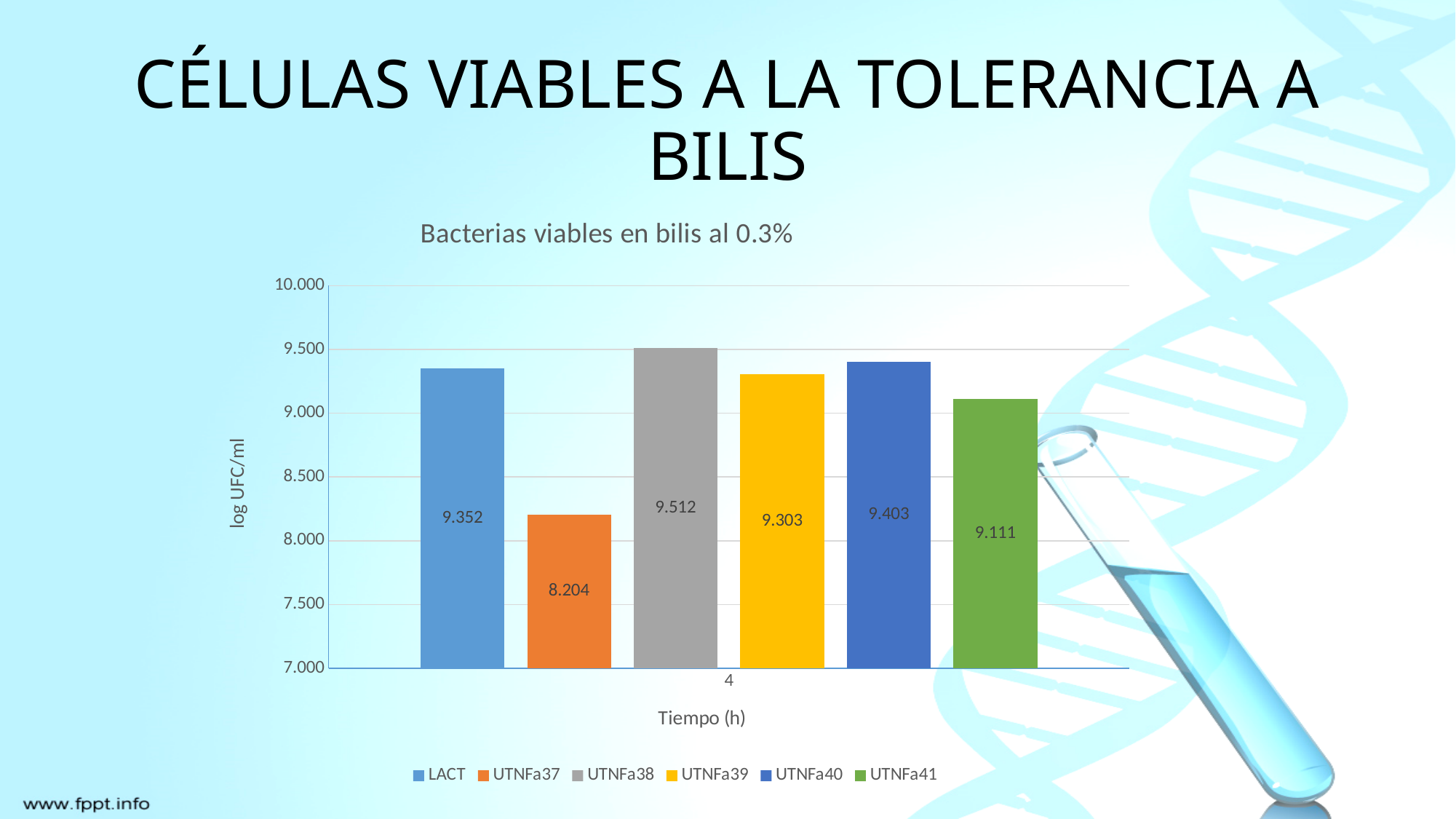
What is the difference between the values for UTNFa40 and UTNFa39? 0.100 Which is larger, the value for LACT or the value for UTNFa41? LACT What is the value for UTNFa41? 9.111 What is the title of the chart? Bacterias viables en bilis al 0.3% What is the difference between the values for UTNFa38 and UTNFa37? 1.308 What type of chart is shown on the slide? bar chart What is the value for UTNFa37? 8.204 Which series has the highest value? UTNFa38 How many series does the legend list? 6 What is the value for LACT? 9.352 What is the label on the y axis? log UFC/ml Which series has the lowest value? UTNFa37